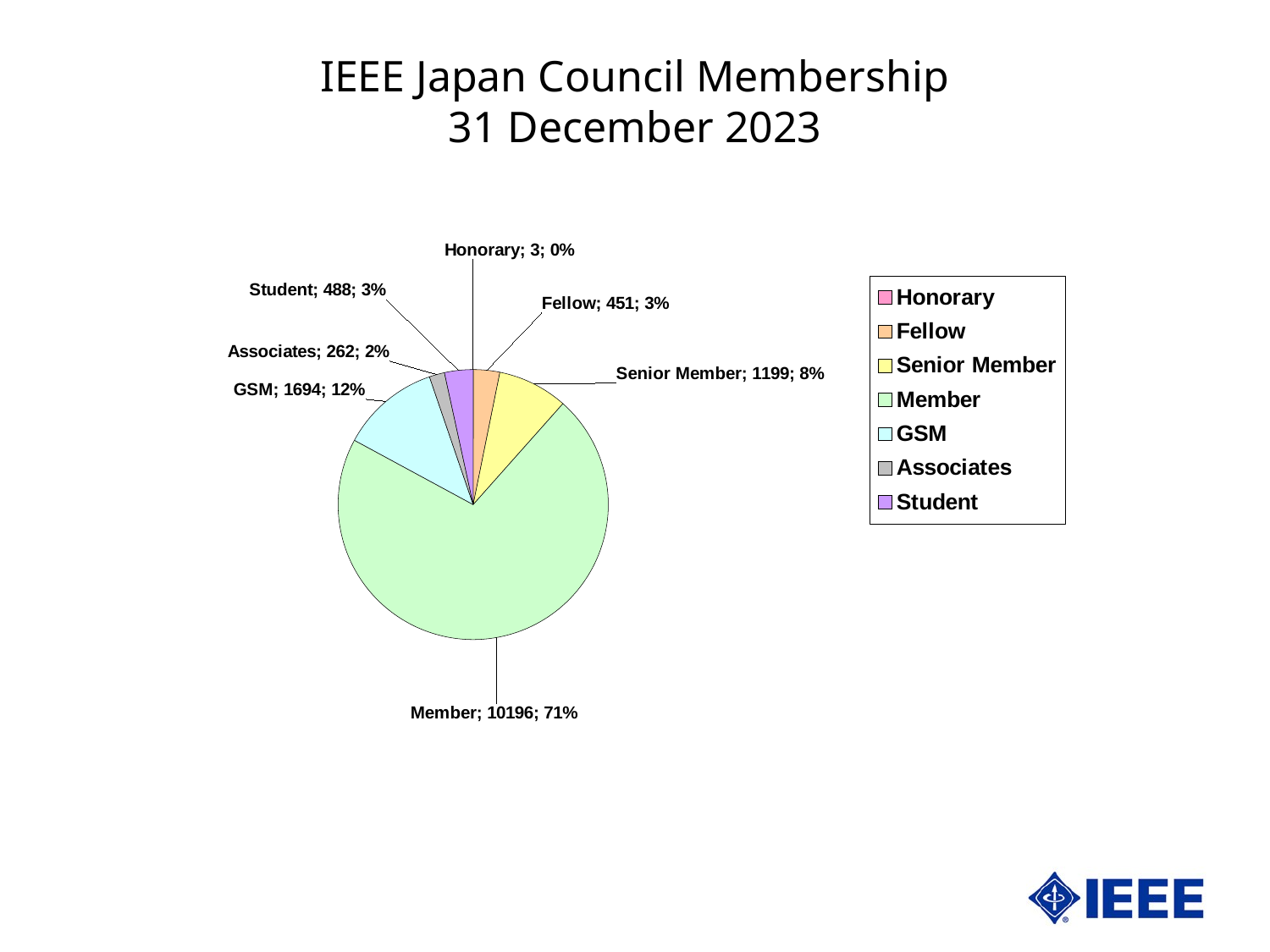
What is the value for Senior Member? 1199 How many members are in the Member category? 10196 What is the value for GSM? 1694 Which category has the smallest slice of the pie? Honorary Which is larger, the value for Fellow or the value for Associates? Fellow What share of the pie does Senior Member represent? 8% Which category has the largest slice of the pie? Member How many categories does the legend list? 7 What kind of chart is shown on the slide? pie chart What share of the pie does GSM represent? 12% What is the title of the chart on the slide? IEEE Japan Council Membership 31 December 2023 What is the difference between the Fellow and Student values? 37